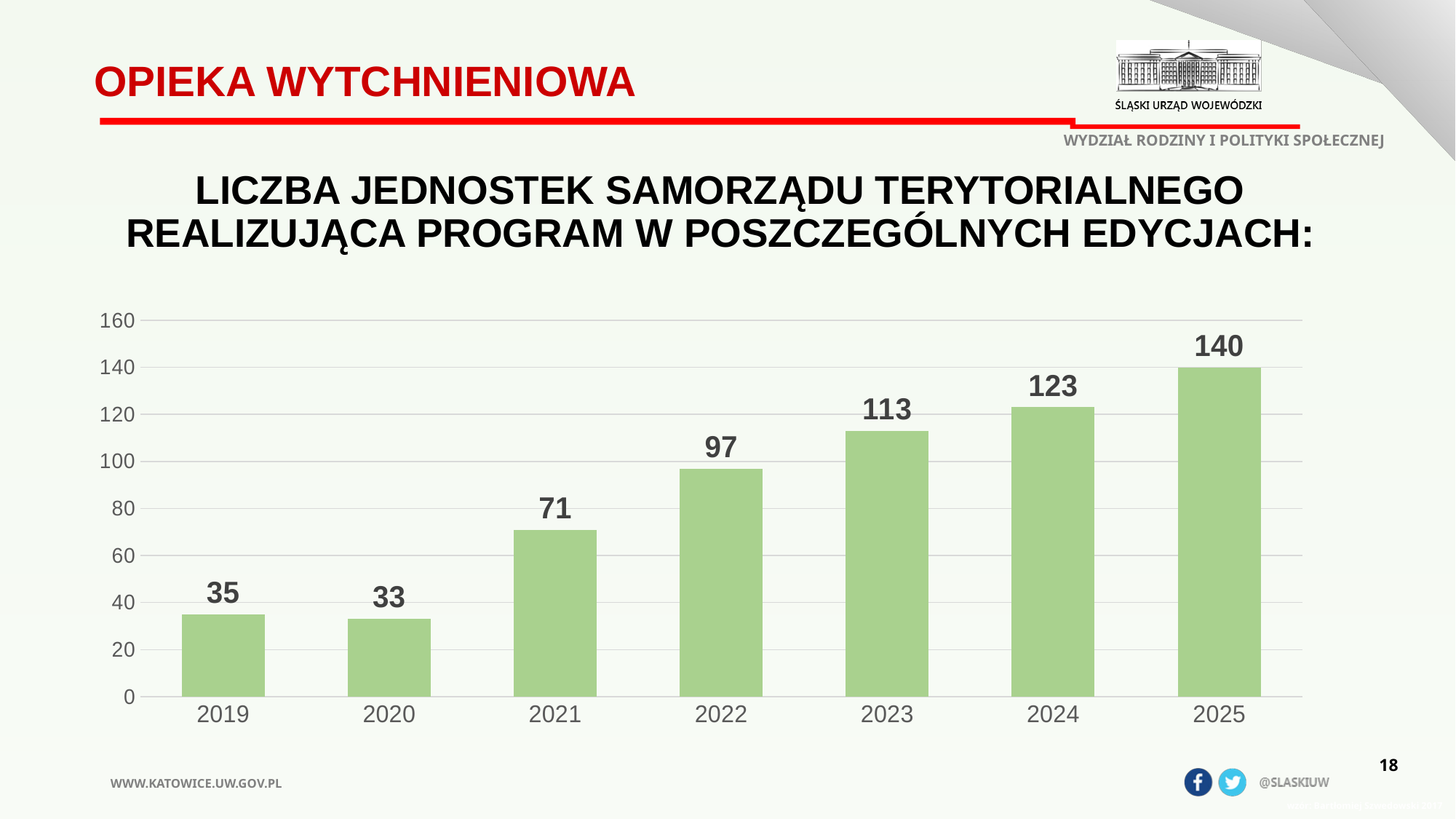
What is the difference between the values for 2025 and 2019? 105 Which year has the highest value? 2025 What colour are the bars in the chart? green Is the value for 2023 greater or less than 100? greater How many years are shown on the x axis? 7 Which is larger, the value for 2022 or the value for 2021? 2022 What is the value for 2021? 71 Do the values generally rise or fall from 2020 to 2025? rise What is the value for 2024? 123 Which year has the lowest value? 2020 What is the difference between the values for 2023 and 2022? 16 What kind of chart is shown on the slide? bar chart